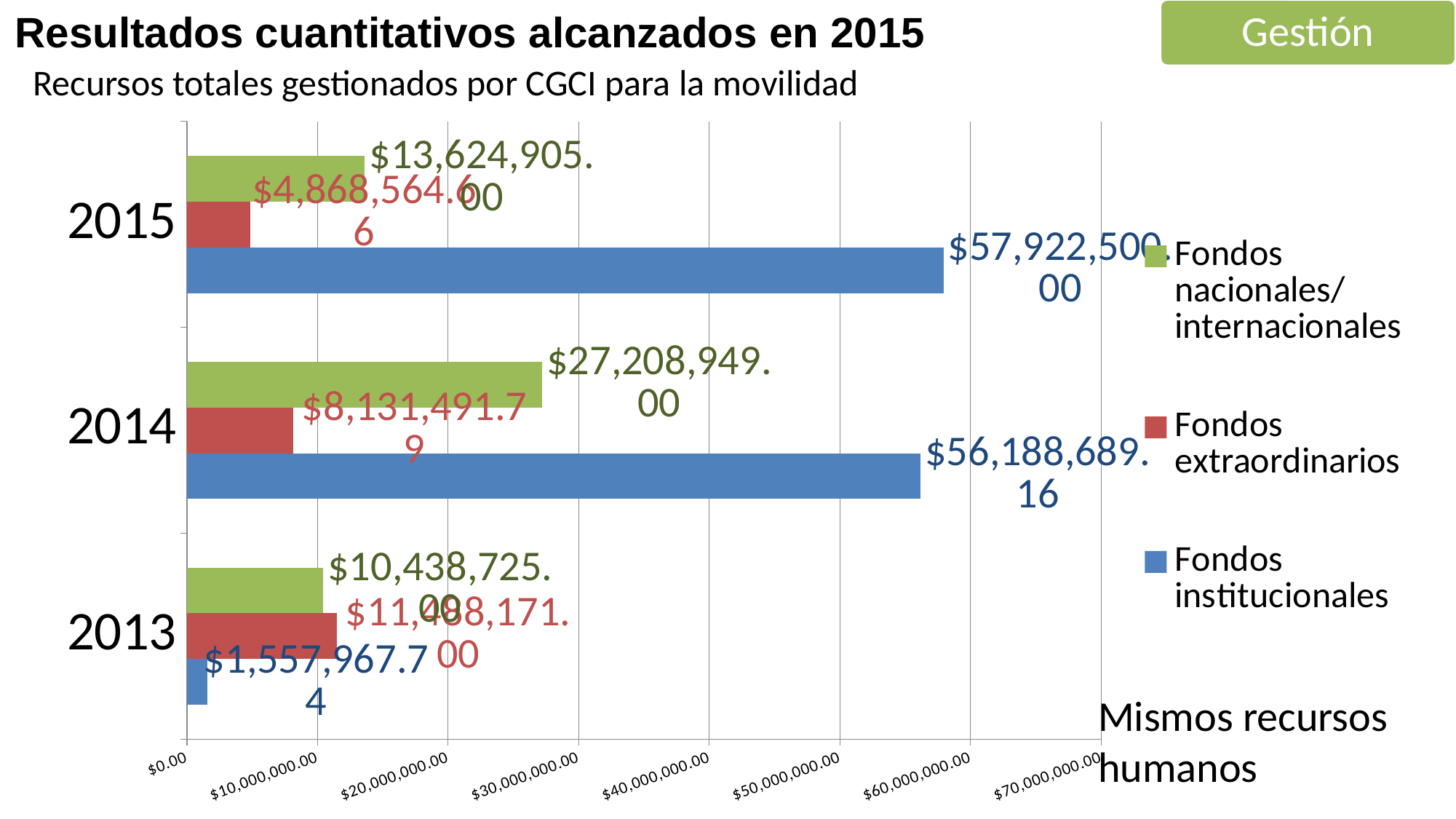
Is the value of Fondos extraordinarios for 2013 greater or less than $10,000,000.00? greater Do the values for Fondos extraordinarios rise or fall from 2013 to 2015? fall What is the value of Fondos nacionales/internacionales for 2014? $27,208,949.00 Which year has the lowest value for Fondos nacionales/internacionales? 2013 What is the value of Fondos institucionales for 2013? $1,557,967.74 How many years are shown on the chart? 3 What is the difference between Fondos institucionales in 2015 and in 2014? $1,733,810.84 How many series does the legend list? 3 Which year has the highest value for Fondos institucionales? 2015 What is the value of Fondos institucionales for 2015? $57,922,500.00 Which is larger, Fondos institucionales in 2014 or in 2015? 2015 What is the value of Fondos extraordinarios for 2015? $4,868,564.66